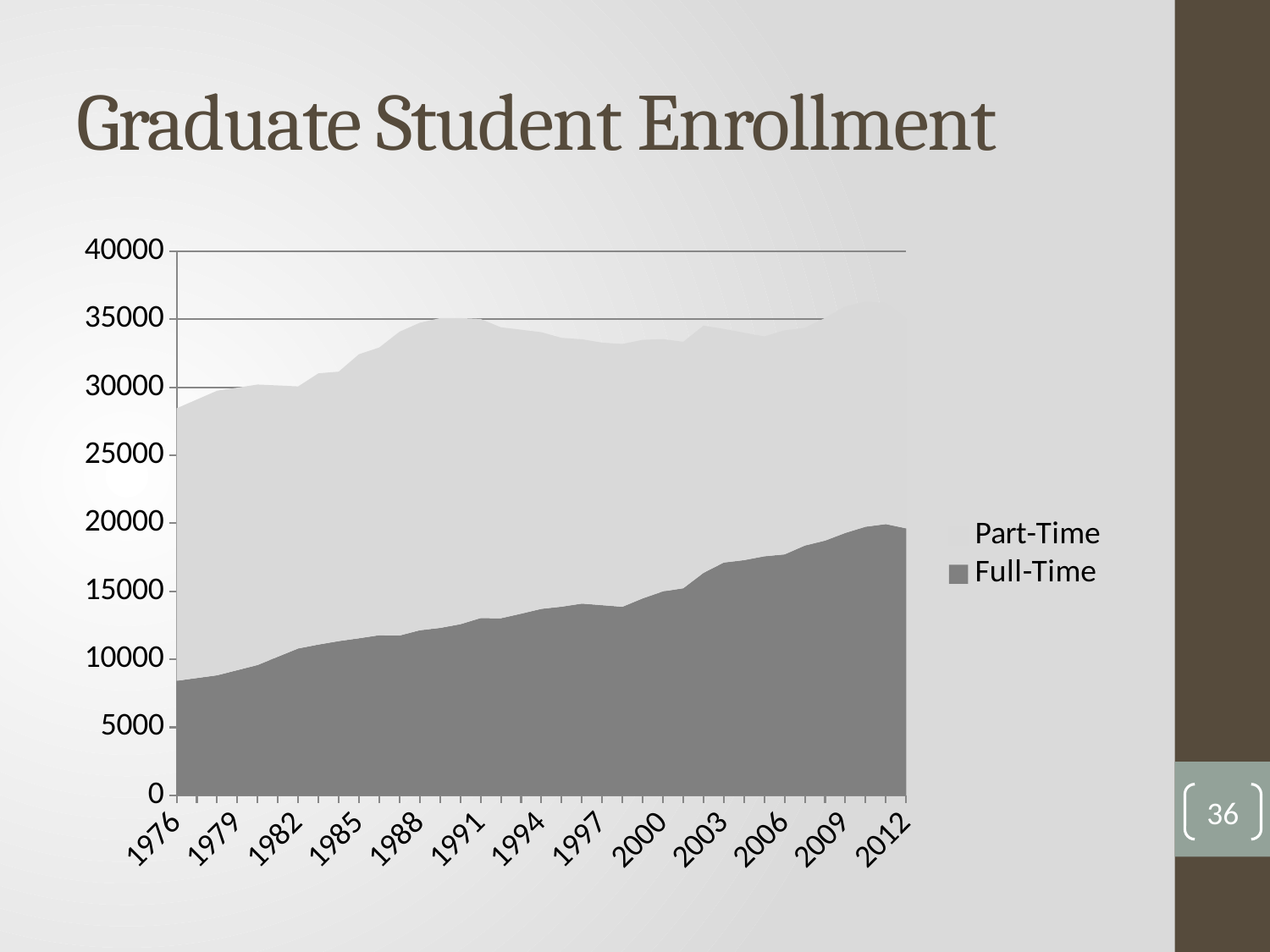
Does the Full-Time enrollment rise or fall from 1976 to 2012? Rises Which series is plotted at the bottom of the stacked area chart? Full-Time Is the Full-Time value for 1976 greater or less than 10000? less How many year labels are shown on the x axis? 13 What is the title of the chart? Graduate Student Enrollment How many series does the legend list? 2 Is the Full-Time value for 2012 greater or less than 15000? greater What kind of chart is shown on the slide? Stacked area chart Is the total enrollment (Full-Time plus Part-Time) for 1988 greater or less than 30000? greater